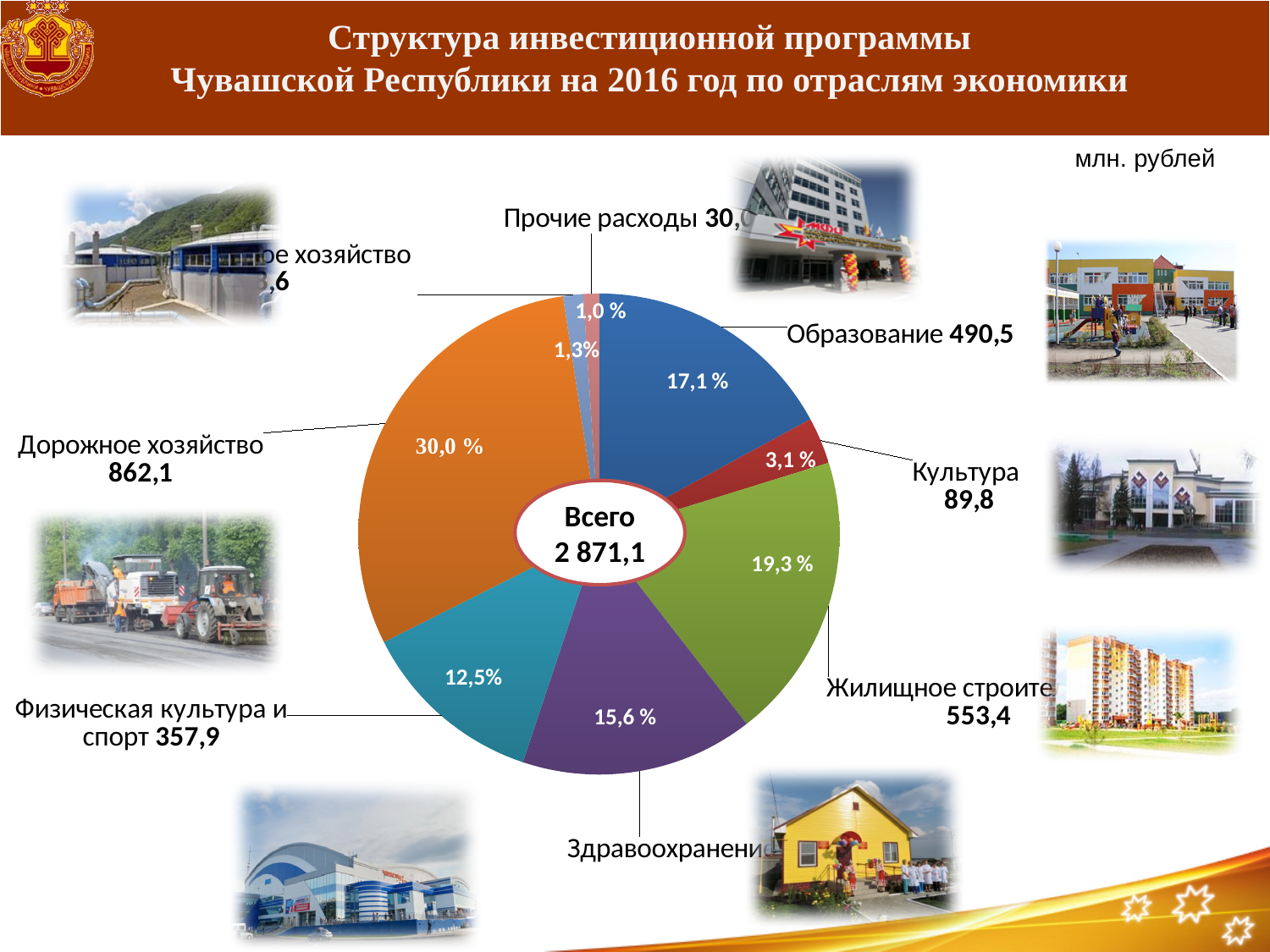
What is the value for Дорожное хозяйство in the pie chart? 862,1 Which sector has the largest slice in the pie chart? Дорожное хозяйство What is the difference between the values for Дорожное хозяйство and Образование? 371,6 Which is larger, the value for Образование or the value for Физическая культура и спорт? Образование What is the value for Образование in the pie chart? 490,5 What is the value for Физическая культура и спорт in the pie chart? 357,9 What is the value for Культура in the pie chart? 89,8 What share of the pie does Дорожное хозяйство take? 30,0 % What kind of chart is shown on the slide? pie chart What share of the pie does Культура take? 3,1 % What total (Всего) is shown in the centre of the pie chart? 2 871,1 What share of the pie does Образование take? 17,1 %